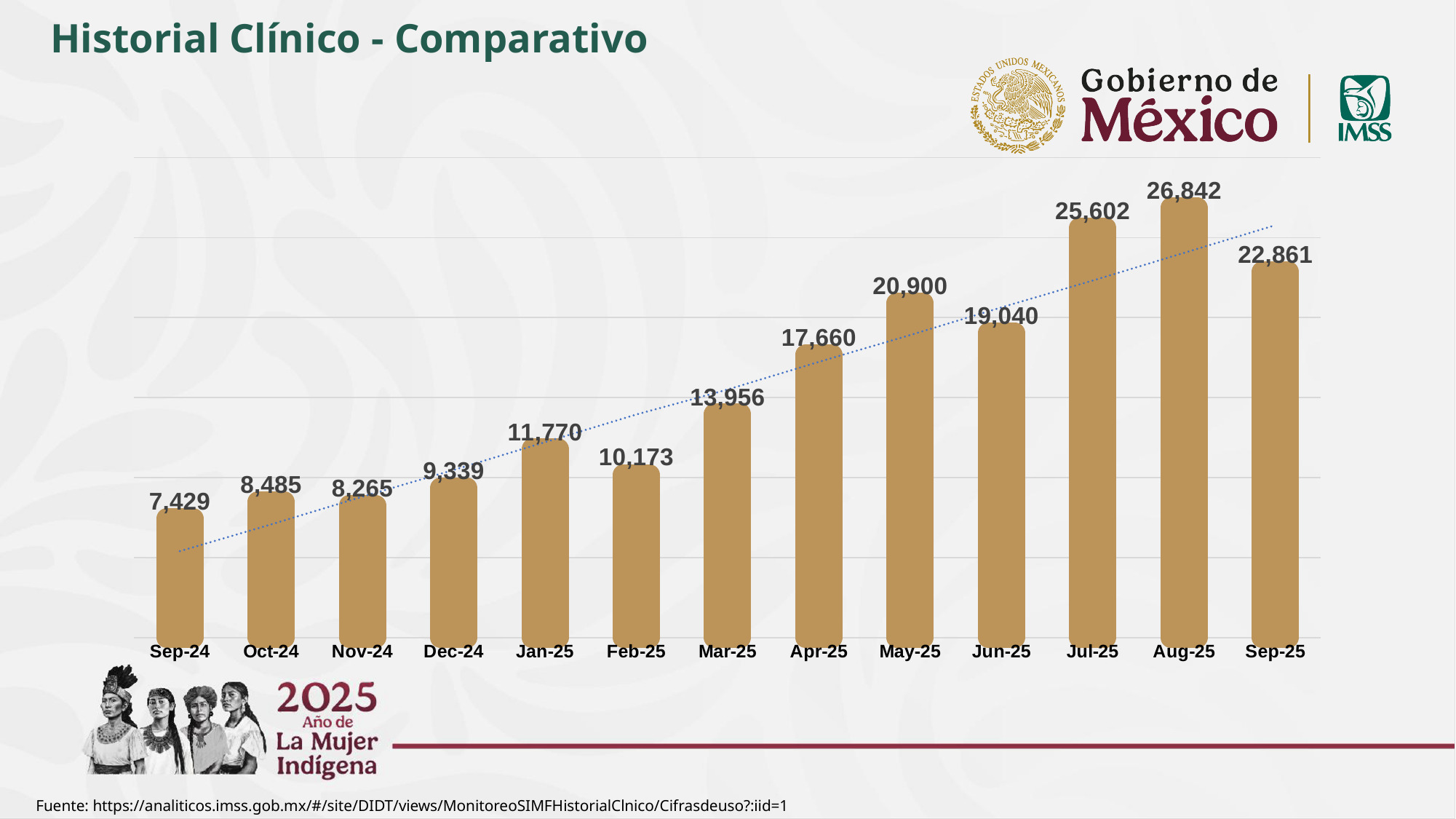
What is the value for Sep-25? 22,861 What is the difference between the values for Jul-25 and Jun-25? 6,562 What is the difference between the values for Aug-25 and Sep-25? 3,981 Which is larger, the value for Oct-24 or the value for Nov-24? Oct-24 How many months are shown on the x axis? 13 What is the value for Sep-24? 7,429 Which is larger, the value for Jan-25 or the value for Feb-25? Jan-25 What kind of chart is shown on the slide? Bar chart What is the value for Mar-25? 13,956 Which month has the highest value? Aug-25 Do the values generally rise or fall from Sep-24 to Aug-25? Rise Which month has the lowest value? Sep-24